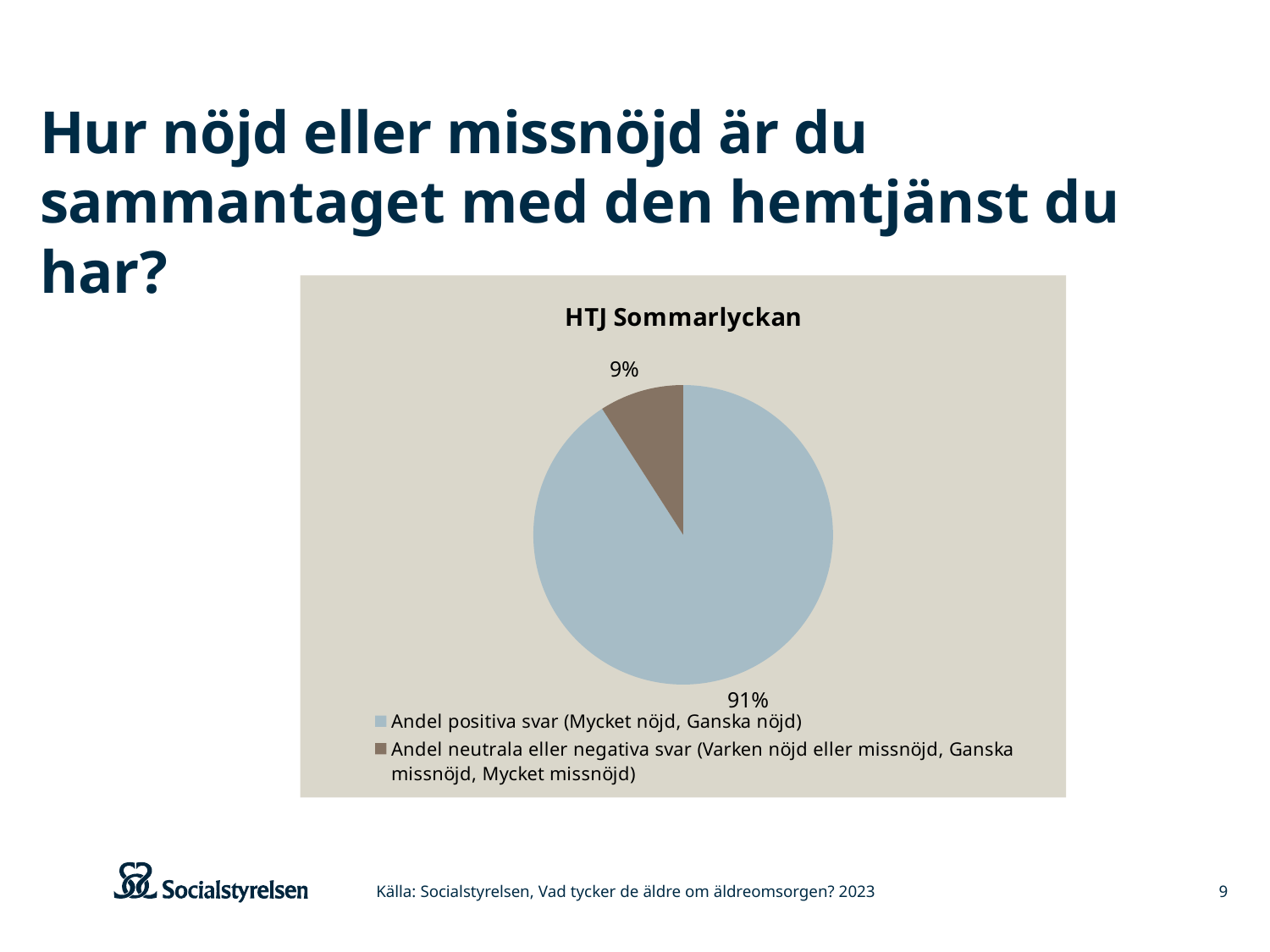
What is the difference in percentage points between the positive-answer slice and the neutral-or-negative slice? 82 How many entries does the legend list? 2 What is the total of the two slice percentages shown? 100% What colour is the slice for 'Andel positiva svar (Mycket nöjd, Ganska nöjd)'? light blue How many slices does the pie chart have? 2 Which is larger: the share of positive answers or the share of neutral or negative answers? Andel positiva svar (Mycket nöjd, Ganska nöjd) Which slice of the pie is the smallest? Andel neutrala eller negativa svar (Varken nöjd eller missnöjd, Ganska missnöjd, Mycket missnöjd) What share of the pie is 'Andel positiva svar (Mycket nöjd, Ganska nöjd)'? 91% Which slice of the pie is the largest? Andel positiva svar (Mycket nöjd, Ganska nöjd) What kind of chart is shown on the slide? pie chart What share of the pie is 'Andel neutrala eller negativa svar (Varken nöjd eller missnöjd, Ganska missnöjd, Mycket missnöjd)'? 9% What is the chart's title? HTJ Sommarlyckan